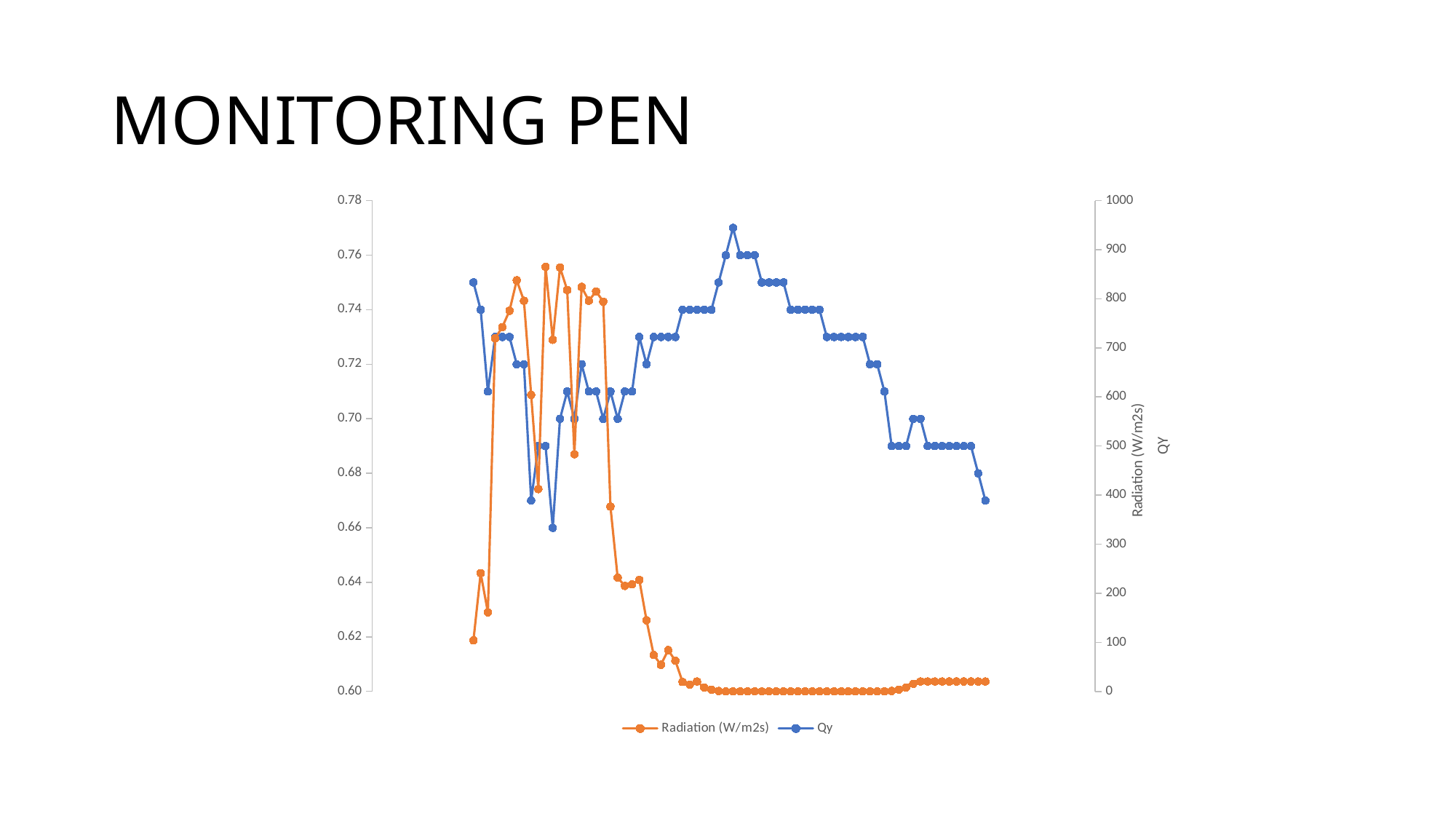
Measured against the left-hand axis, is the highest point of the Qy series greater or less than 0.76? greater What is the highest tick value shown on the right-hand vertical axis? 1000 What kind of chart is shown on the slide? Line chart Which series is drawn in orange? Radiation (W/m2s) How many series does the legend list? 2 Measured against the left-hand axis, are the final points of the Radiation (W/m2s) series greater or less than 0.62? less Measured against the left-hand axis, is the lowest point of the Qy series greater or less than 0.68? less